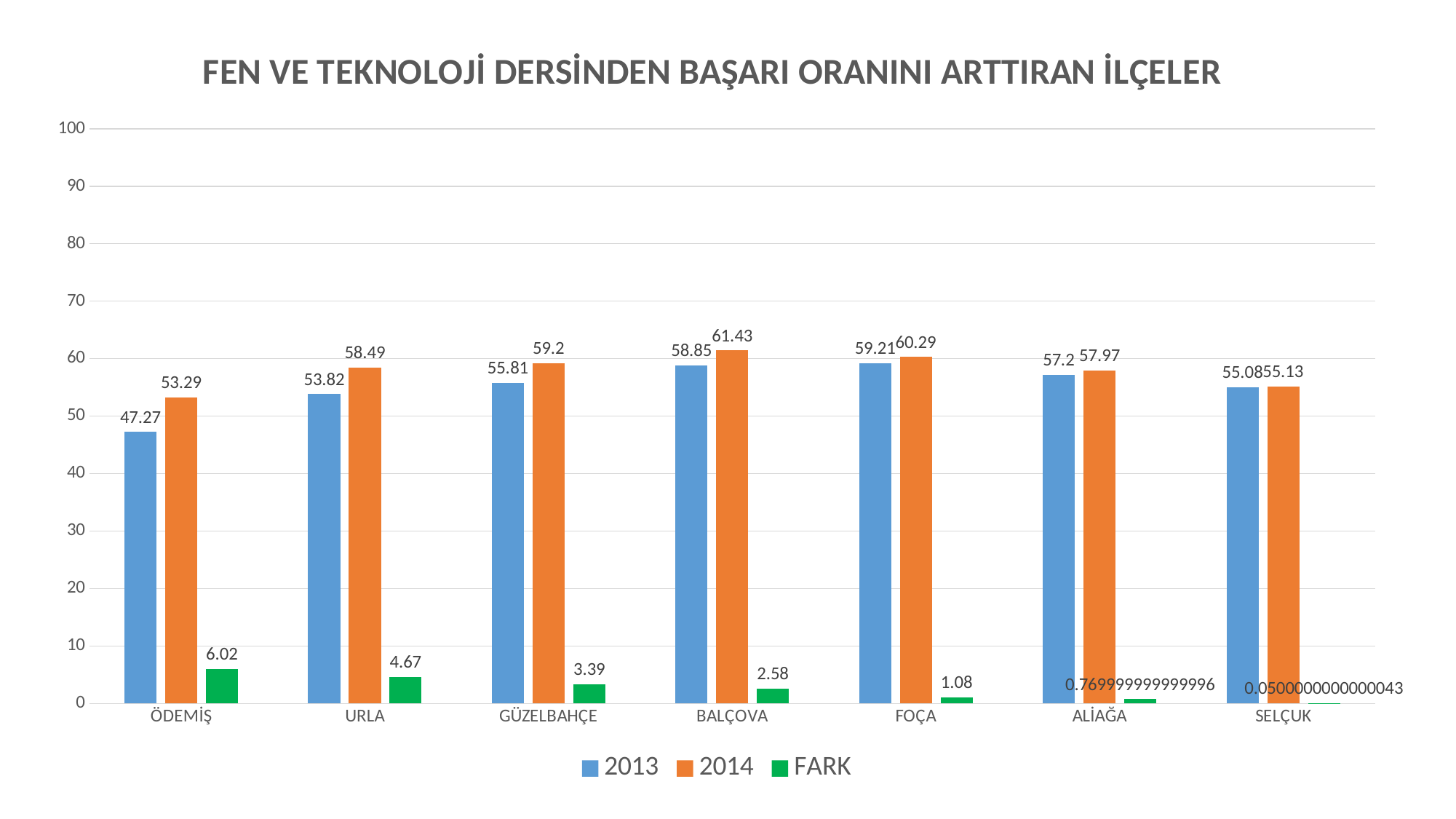
Which district has the largest FARK value? ÖDEMİŞ What is the 2014 value for BALÇOVA? 61.43 What is the difference between the 2014 and 2013 values for ÖDEMİŞ? 6.02 How many series does the legend list? 3 Which is larger, the 2013 value for FOÇA or the 2013 value for BALÇOVA? FOÇA What is the 2014 value for GÜZELBAHÇE? 59.2 How many districts are shown on the x axis? 7 What type of chart is shown on the slide? Bar chart Which district has the highest 2014 value? BALÇOVA What is the FARK value for URLA? 4.67 What is the 2013 value for ÖDEMİŞ? 47.27 Which district has the lowest 2013 value? ÖDEMİŞ